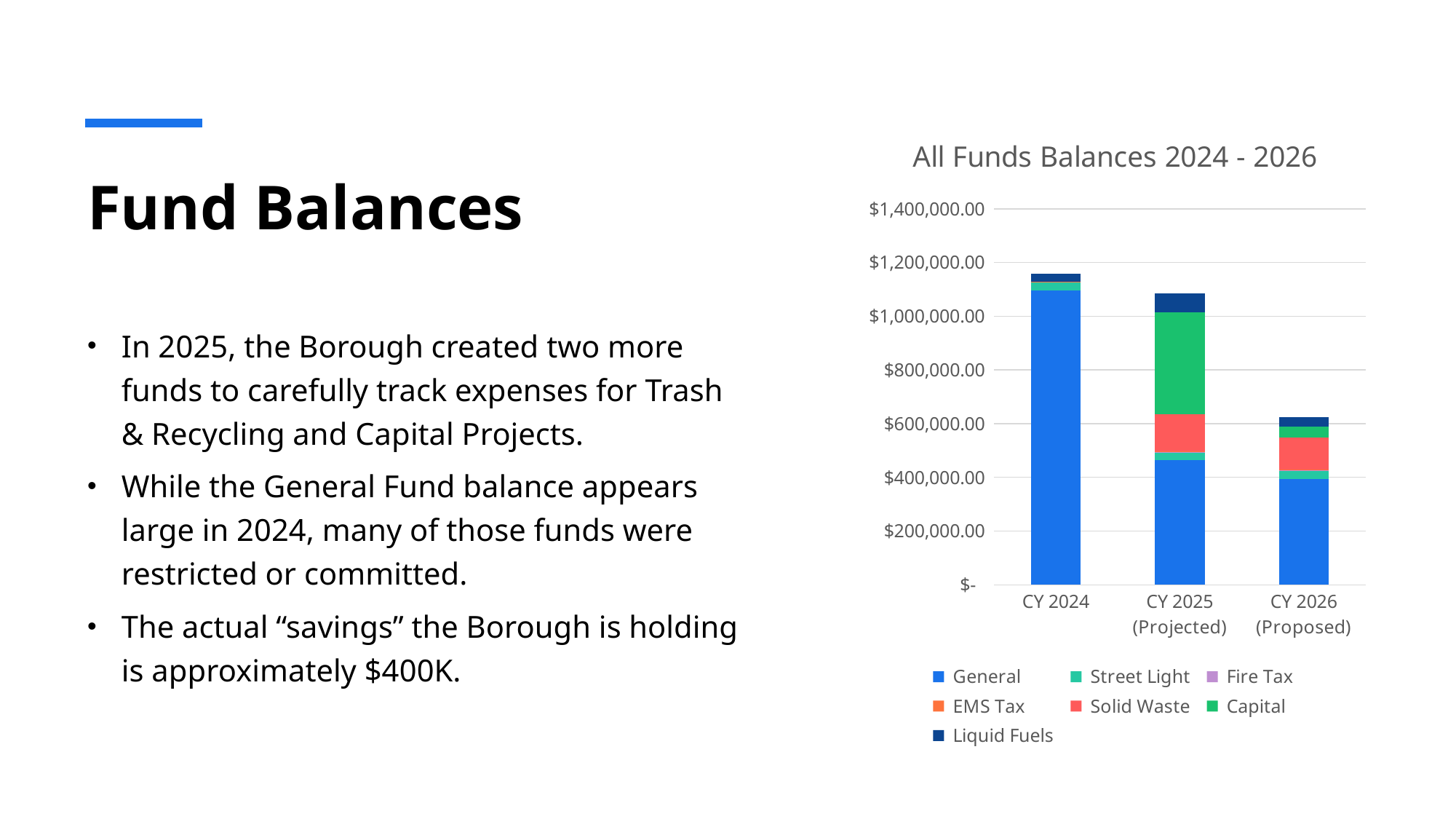
What kind of chart is shown on the slide? stacked bar chart Which year has the lowest total fund balance? CY 2026 (Proposed) How many series does the chart legend list? 7 Which year has the highest total fund balance? CY 2024 Is the General fund balance for CY 2025 (Projected) greater or less than $600,000.00? less Which is larger, the total fund balance for CY 2024 or for CY 2026 (Proposed)? CY 2024 Is the total fund balance for CY 2026 (Proposed) greater or less than $800,000.00? less In which year is the Capital fund segment the largest? CY 2025 (Projected) Is the total fund balance for CY 2024 greater or less than $1,000,000.00? greater How many bars (years) are shown on the x axis? 3 Do the total fund balances rise or fall from CY 2024 to CY 2026? fall What is the title of the chart? All Funds Balances 2024 - 2026